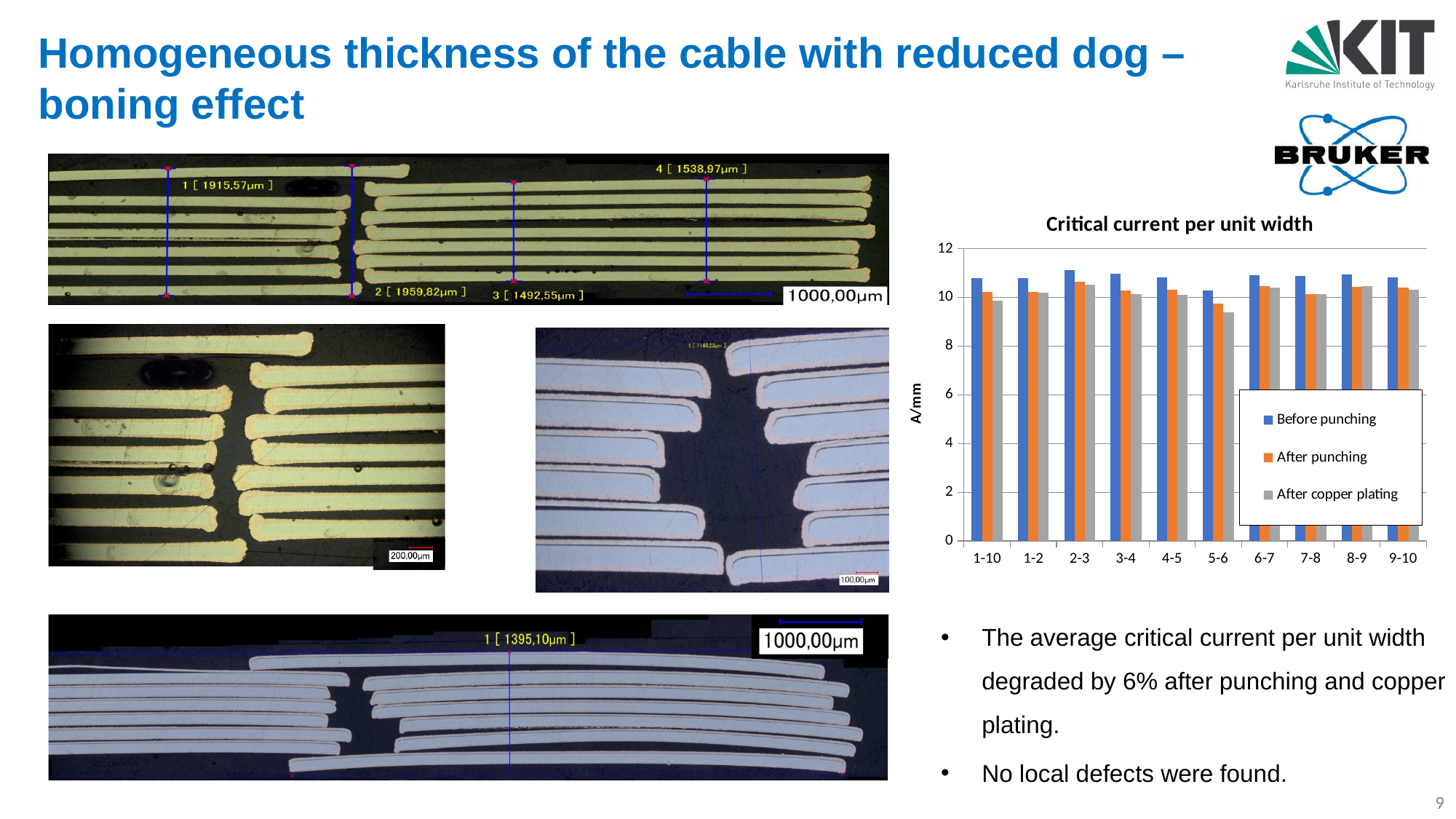
In the 'Critical current per unit width' chart, is the 'Before punching' value for 2-3 greater or less than 10? greater In the 'Critical current per unit width' chart, is the 'After punching' value for 5-6 greater or less than 10? less In the 'Critical current per unit width' chart, for category 1-10, which is larger: 'Before punching' or 'After copper plating'? Before punching How many series does the legend of the 'Critical current per unit width' chart list? 3 What is the y-axis label of the 'Critical current per unit width' chart? A/mm In the 'Critical current per unit width' chart, is the 'After copper plating' value for 1-10 greater or less than 8? greater What kind of chart is 'Critical current per unit width'? bar chart How many categories are shown on the x axis of the 'Critical current per unit width' chart? 10 In the 'Critical current per unit width' chart, for category 5-6, which is larger: 'Before punching' or 'After copper plating'? Before punching In the 'Critical current per unit width' chart, which category has the lowest 'Before punching' value? 5-6 In the 'Critical current per unit width' chart, which category has the lowest 'After copper plating' value? 5-6